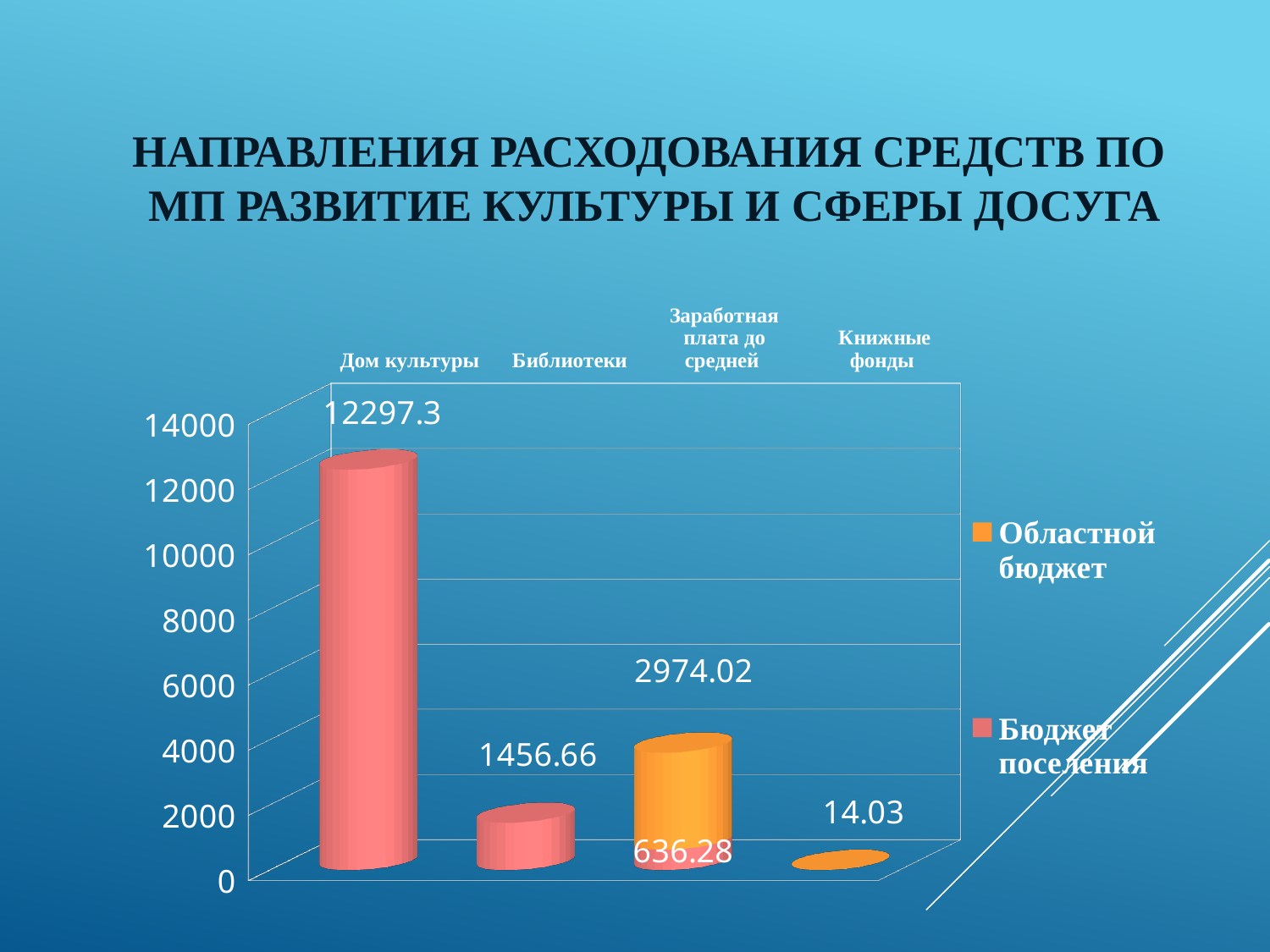
What kind of chart is shown on the slide? Bar chart What is the difference between the Бюджет поселения values for Дом культуры and Библиотеки? 10840.64 Which category has the highest value for Бюджет поселения? Дом культуры What is the value of Бюджет поселения for Заработная плата до средней? 636.28 What is the total of the stacked bar for Заработная плата до средней? 3610.3 What is the value of Бюджет поселения for Библиотеки? 1456.66 What is the value of Бюджет поселения for Дом культуры? 12297.3 What is the value of Областной бюджет for Заработная плата до средней? 2974.02 How many categories are shown on the x axis? 4 Which is larger: the Областной бюджет value for Заработная плата до средней or the Бюджет поселения value for Библиотеки? Областной бюджет for Заработная плата до средней What is the value of Областной бюджет for Книжные фонды? 14.03 How many series does the legend list? 2